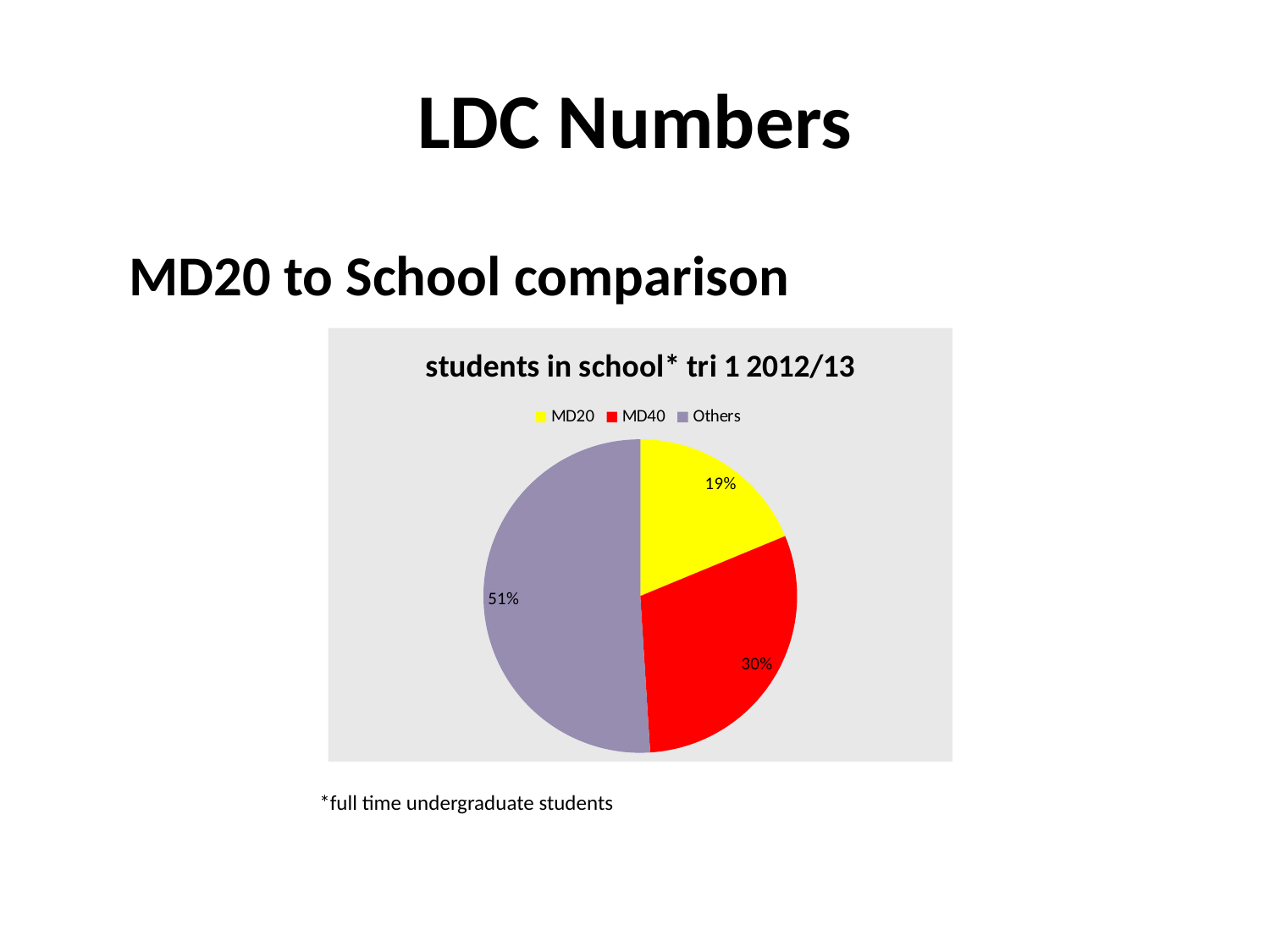
Which is larger, the share for MD40 or the share for MD20? MD40 What colour is the MD40 slice? red How many categories does the pie chart show? 3 What is the difference in percentage points between the Others slice and the MD40 slice? 21 What is the difference in percentage points between the MD40 slice and the MD20 slice? 11 What kind of chart is shown on the slide? pie chart What share of the pie does MD20 represent? 19% Which category has the smallest slice of the pie? MD20 What share of the pie does MD40 represent? 30% Which category has the largest slice of the pie? Others What is the title of the chart? students in school* tri 1 2012/13 What share of the pie does Others represent? 51%